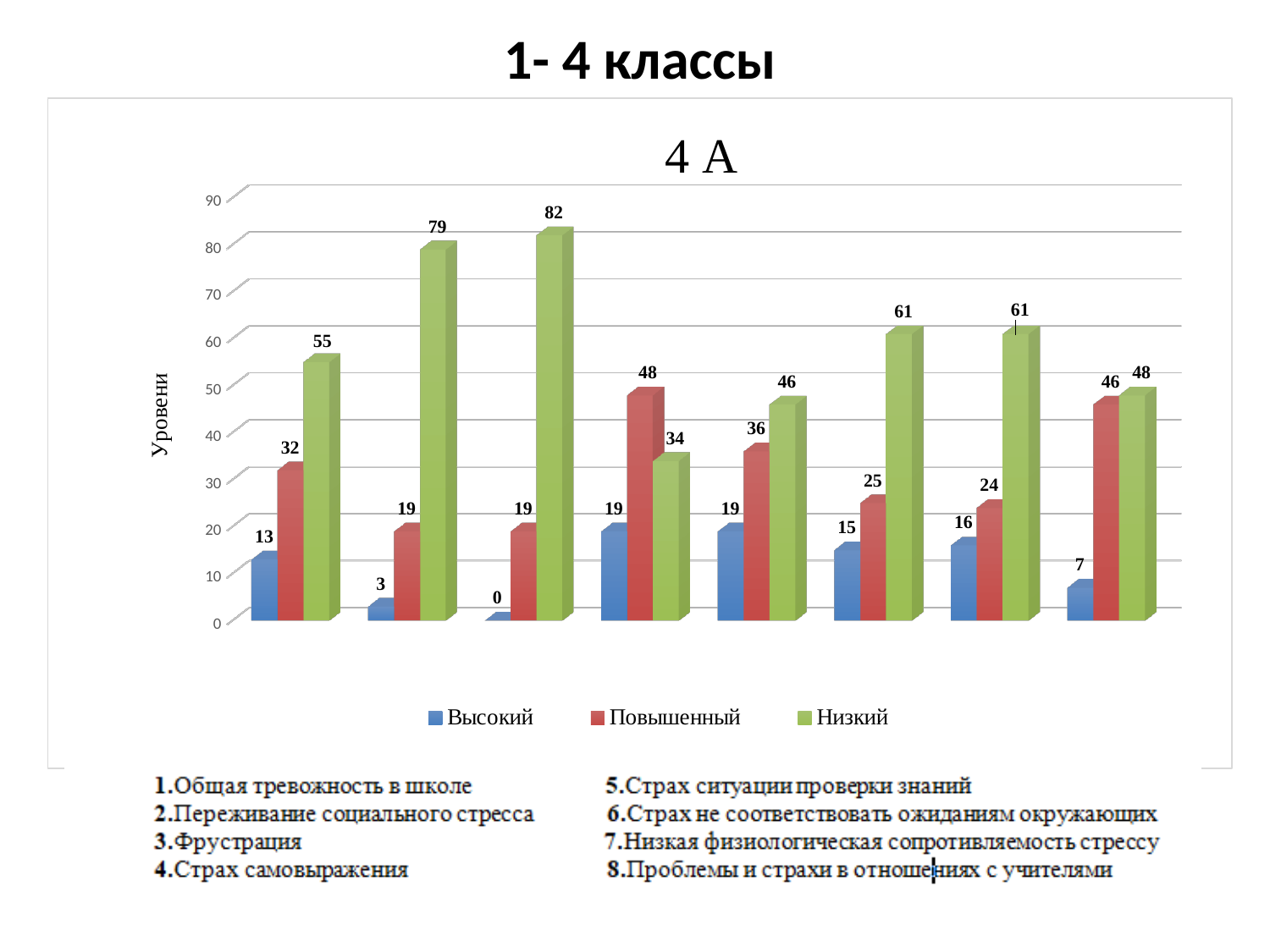
What is the Низкий value for the third group of bars (Фрустрация)? 82 What is the highest Повышенный value in the chart? 48 Which group of bars has the lowest Высокий value? the third group (Фрустрация), 0 What kind of chart is shown on the slide? bar chart Which group of bars has the highest Низкий value? the third group (Фрустрация), 82 How many groups of bars are plotted in the chart? 8 What is the Повышенный value for the fifth group of bars (Страх ситуации проверки знаний)? 36 What is the Высокий value for the eighth group of bars (Проблемы и страхи в отношениях с учителями)? 7 How many series does the legend of the chart list? 3 What is the title of the chart? 4 А In the fourth group of bars (Страх самовыражения), which is larger: Повышенный or Низкий? Повышенный In the first group of bars (Общая тревожность в школе), what is the difference between the Повышенный and Высокий values? 19